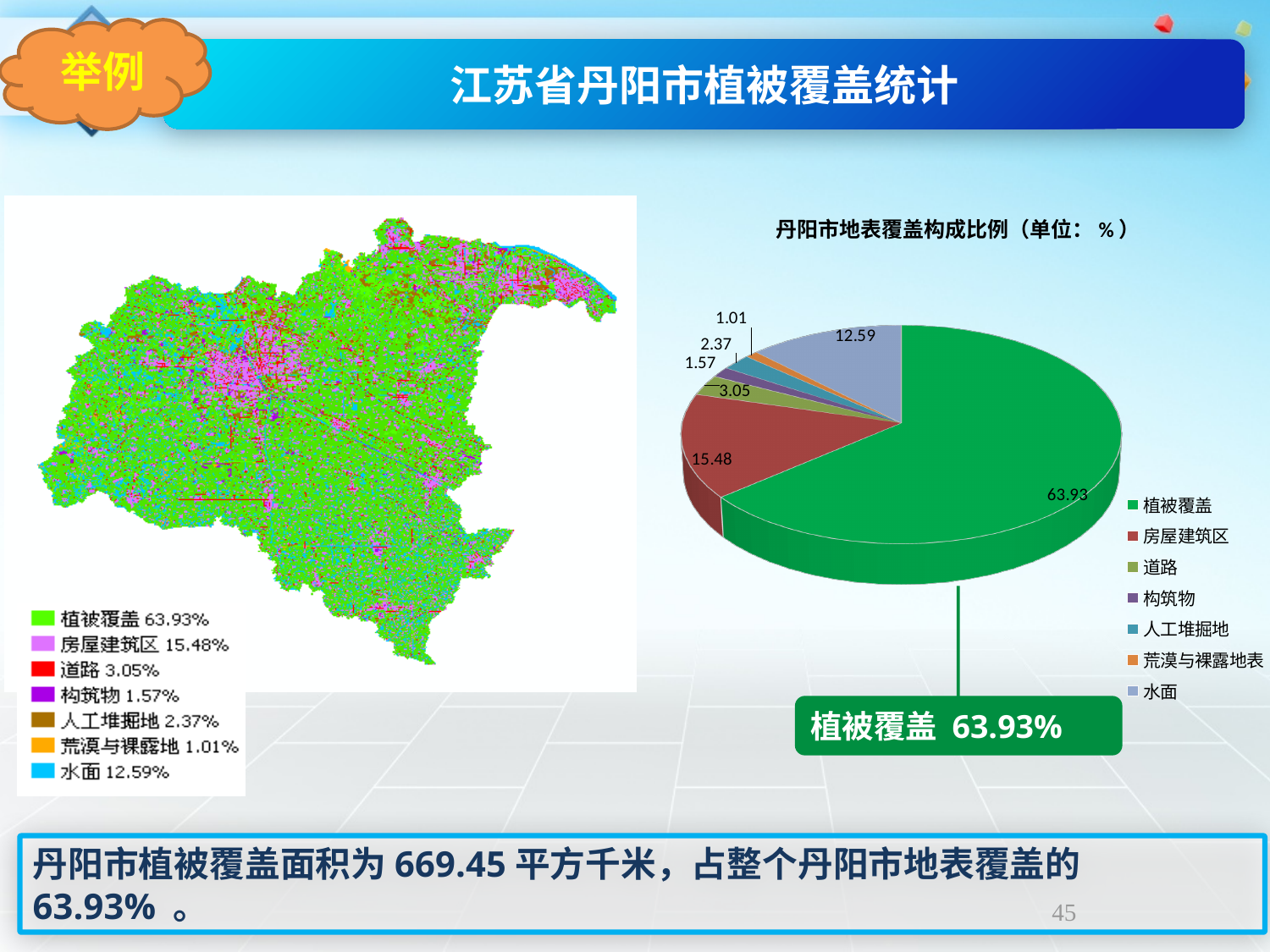
In the pie chart, what is the difference between the values for 植被覆盖 and 房屋建筑区? 48.45 In the pie chart, which is larger, the value for 水面 or the value for 房屋建筑区? 房屋建筑区 What kind of chart is shown under the title 丹阳市地表覆盖构成比例（单位：%）? pie chart How many categories does the legend of the pie chart list? 7 In the pie chart, what is the value labelled for 人工堆掘地? 2.37 In the pie chart, what is the value labelled for 植被覆盖? 63.93 In the pie chart, what is the value labelled for 房屋建筑区? 15.48 In the pie chart, what is the value labelled for 水面? 12.59 In the pie chart, what is the value labelled for 道路? 3.05 Which category has the smallest slice in the pie chart? 荒漠与裸露地表 Which category has the largest slice in the pie chart? 植被覆盖 What is the title of the pie chart? 丹阳市地表覆盖构成比例（单位：%）